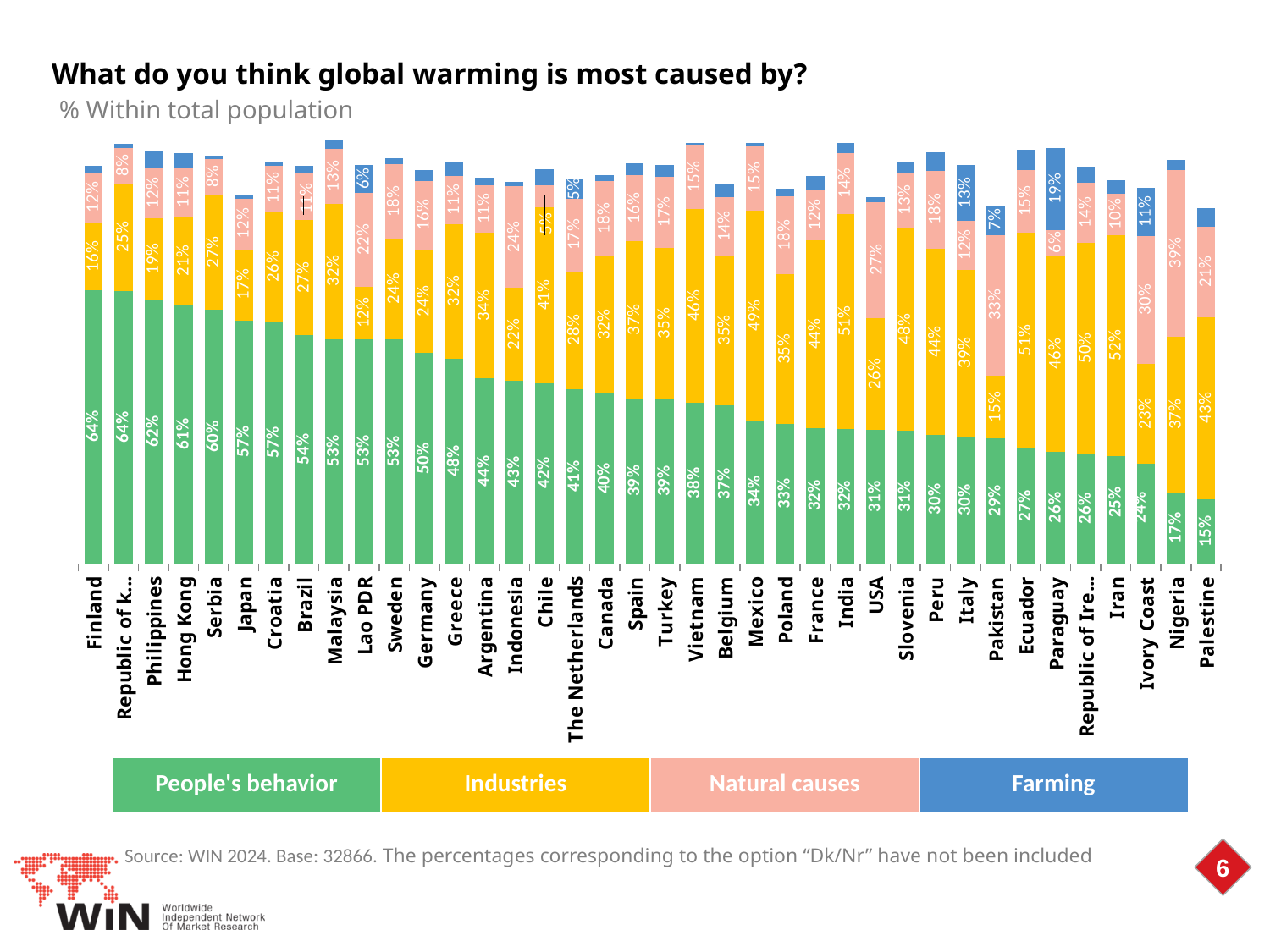
What is the difference between the People's behavior values for Finland and Palestine? 49 percentage points What is the Natural causes value for Nigeria? 39% What percentage of respondents in Finland think global warming is most caused by people's behavior? 64% What is the Farming value for Paraguay? 19% How many series does the legend list? 4 How many countries are shown on the x axis? 38 Which country has the highest Industries value? Iran Which country has the lowest People's behavior value? Palestine Which has a larger Industries value, Vietnam or Belgium? Vietnam What is the Industries value for Iran? 52% What kind of chart is shown on the slide? Stacked bar chart Do the People's behavior values rise or fall from left to right along the x axis? Fall